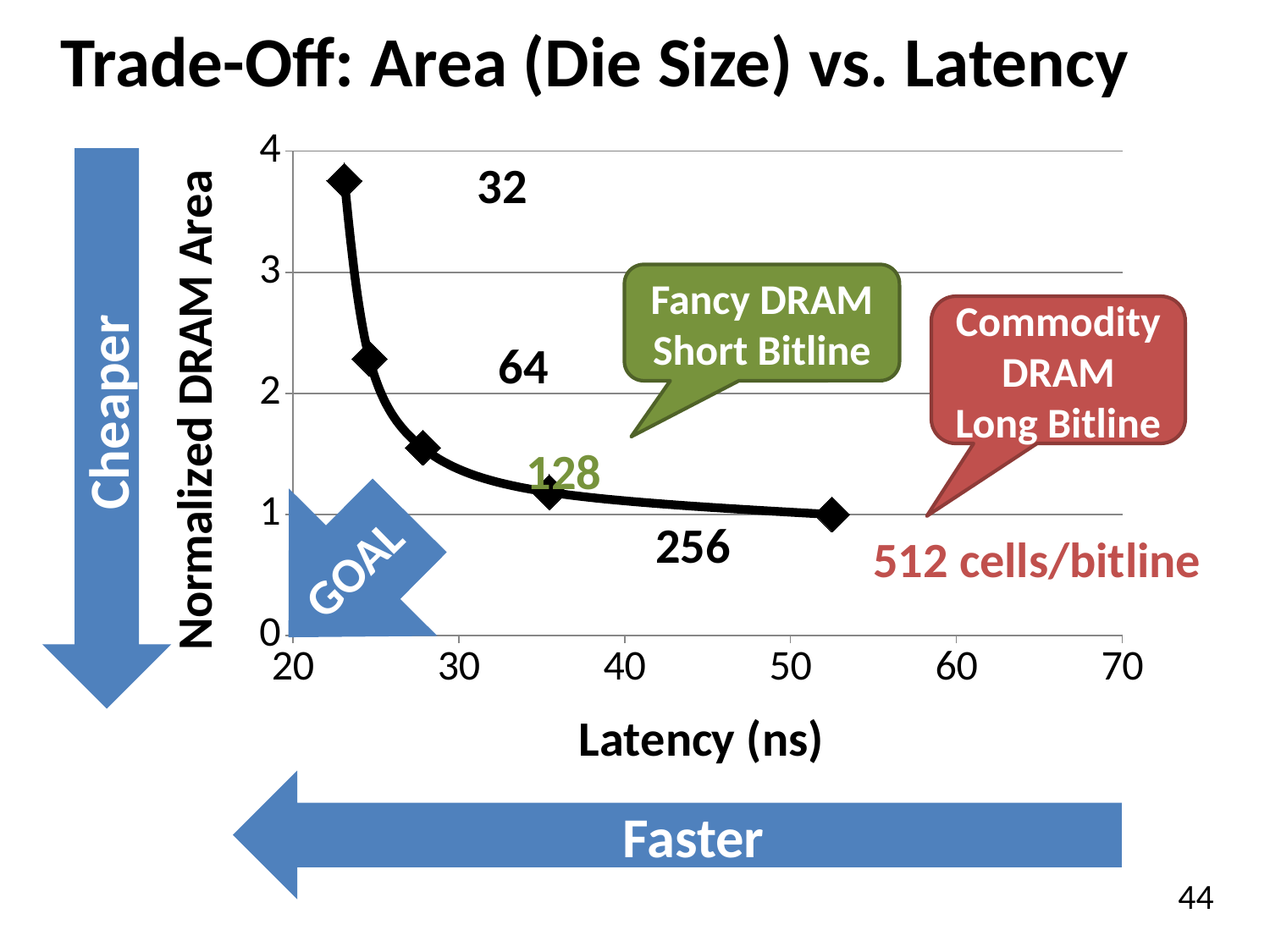
What is the title of the y axis? Normalized DRAM Area Which cells/bitline configuration has the highest normalized DRAM area? 32 Is the normalized DRAM area for 128 cells/bitline greater or less than 2? less What kind of chart is shown on the slide? line chart Which has the larger normalized DRAM area, 64 cells/bitline or 128 cells/bitline? 64 How many data points are plotted on the chart? 5 As latency increases along the x axis, does the normalized DRAM area rise or fall? fall Which cells/bitline configuration has the lowest normalized DRAM area? 512 What is the normalized DRAM area for 512 cells/bitline? 1 What is the title of the x axis? Latency (ns) Is the normalized DRAM area for 32 cells/bitline greater or less than 3? greater Is the latency for 512 cells/bitline greater or less than 50 ns? greater